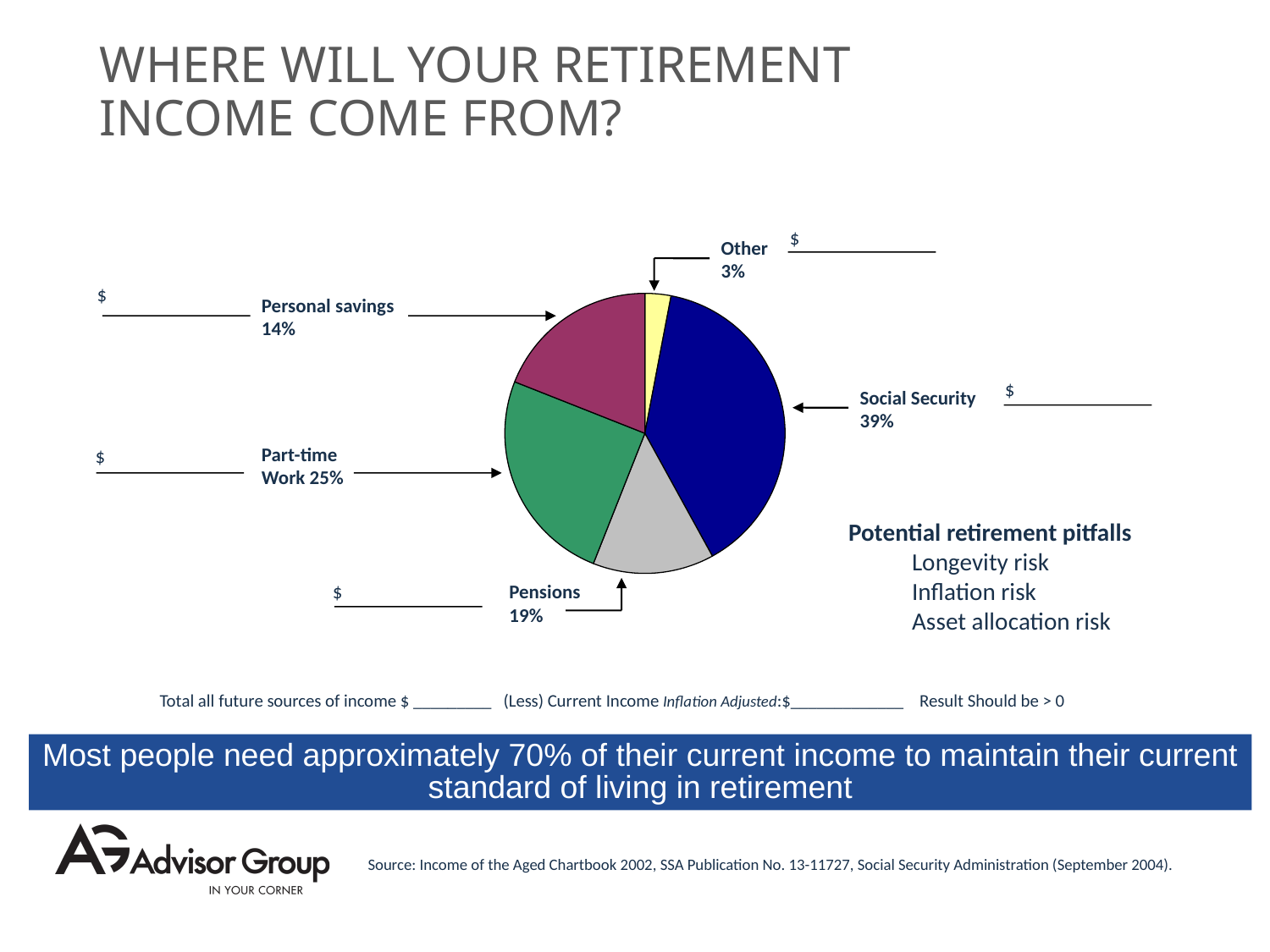
What colour is the Social Security slice of the pie? Dark blue What share of retirement income comes from Social Security? 39% Which source of retirement income has the largest share of the pie? Social Security Which source of retirement income has the smallest share of the pie? Other What share of retirement income comes from Personal savings? 14% What kind of chart is shown on the slide? Pie chart How many slices does the pie chart have? 5 What share of retirement income comes from Part-time Work? 25% Which is larger, the share for Part-time Work or the share for Personal savings? Part-time Work What share of retirement income comes from Pensions? 19% How many percentage points larger is the Social Security share than the Pensions share? 20 What share of retirement income comes from Other sources? 3%